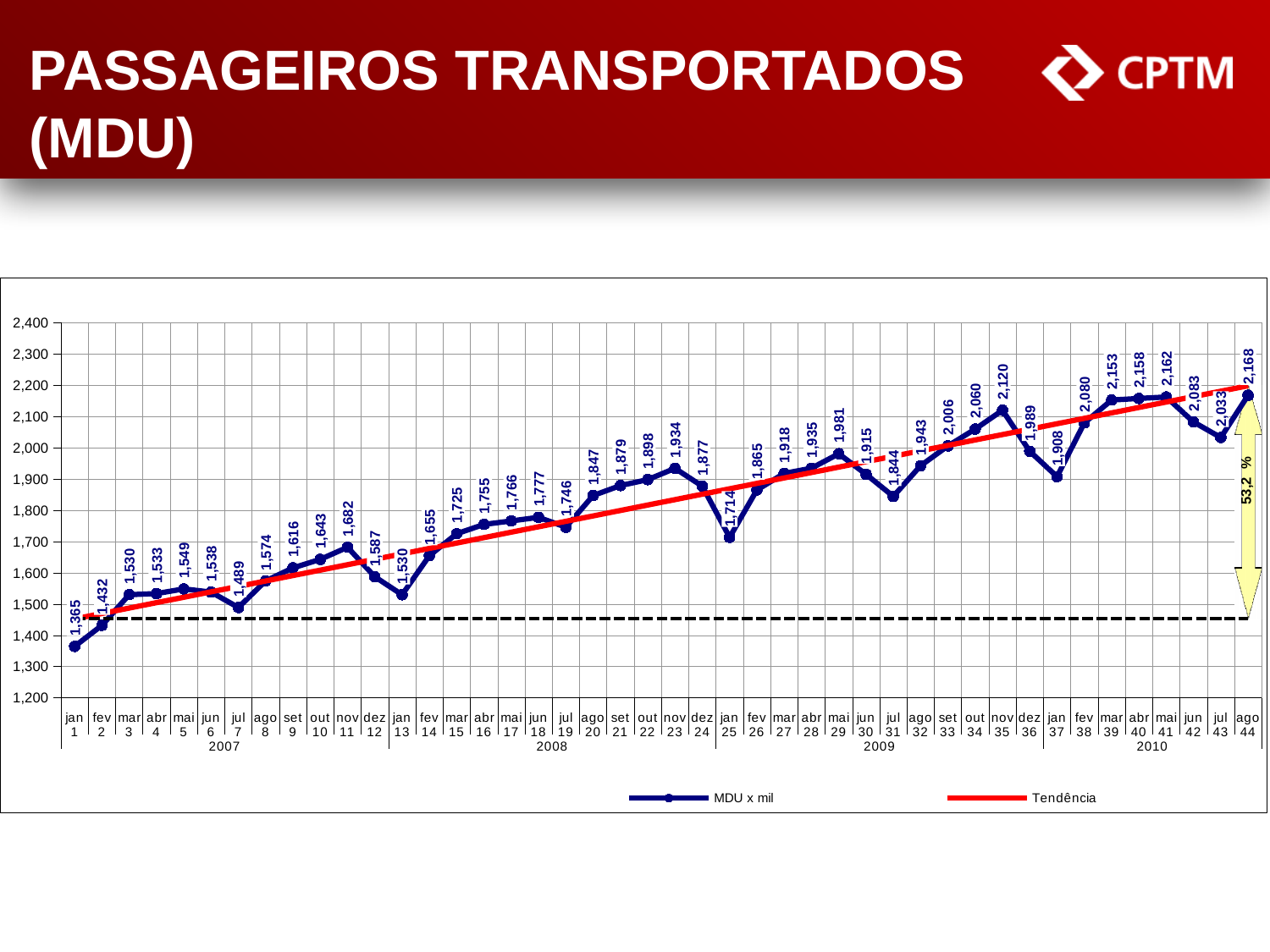
How many monthly data points are plotted on the chart? 44 What is the MDU x mil value for jan 2007 (point 1)? 1,365 What is the MDU x mil value for ago 2010 (point 44)? 2,168 Which month has the highest MDU x mil value? ago 2010 Which month has the lowest MDU x mil value? jan 2007 What type of chart is shown on the slide? line chart What is the MDU x mil value for nov 2009 (point 35)? 2,120 What is the MDU x mil value for jan 2009 (point 25)? 1,714 How many series does the legend list? 2 What is the difference between the MDU x mil values for ago 2010 and jan 2007? 803 Does the MDU x mil series generally rise or fall from jan 2007 to ago 2010? rise Which is larger, the MDU x mil value for dez 2008 or for jan 2009? dez 2008